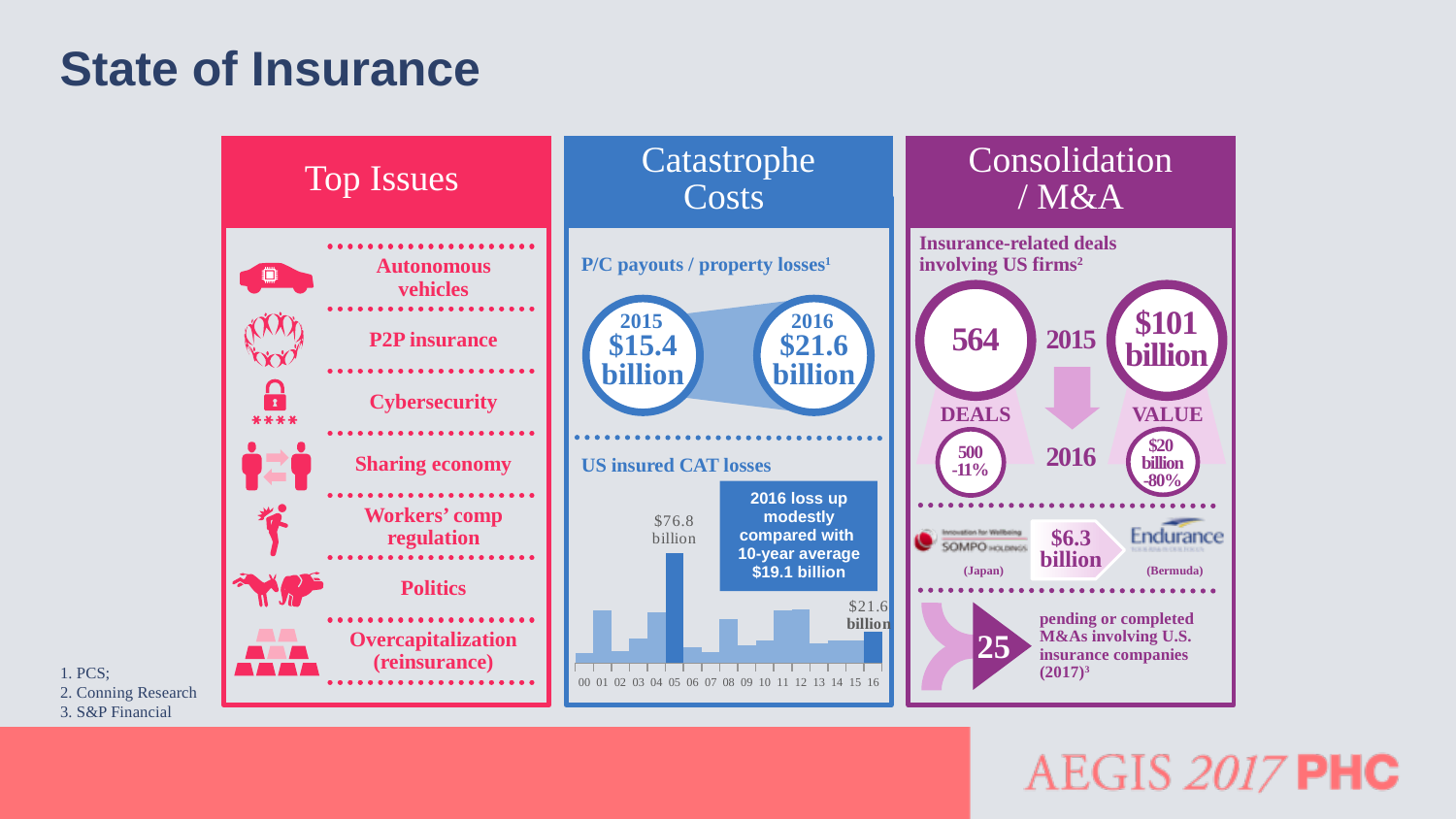
In the 'US insured CAT losses' chart, what is the difference between the 2005 value and the 2016 value? $55.2 billion In the 'US insured CAT losses' chart, which year has the larger value, 2005 or 2016? 2005 What is the first year shown on the x axis of the 'US insured CAT losses' chart? 00 In the 'US insured CAT losses' chart, which year has the larger value, 2004 or 2005? 2005 According to the callout on the 'US insured CAT losses' chart, what is the 10-year average loss? $19.1 billion In the 'US insured CAT losses' chart, what is the labelled value for 2016? $21.6 billion How many years (bars) are shown on the x axis of the 'US insured CAT losses' chart? 17 In the 'US insured CAT losses' chart, which year has the highest insured CAT losses? 05 What kind of chart is the 'US insured CAT losses' chart? bar chart In the 'US insured CAT losses' chart, which year has the larger value, 2000 or 2001? 2001 In the 'US insured CAT losses' chart, what is the labelled value for 2005? $76.8 billion